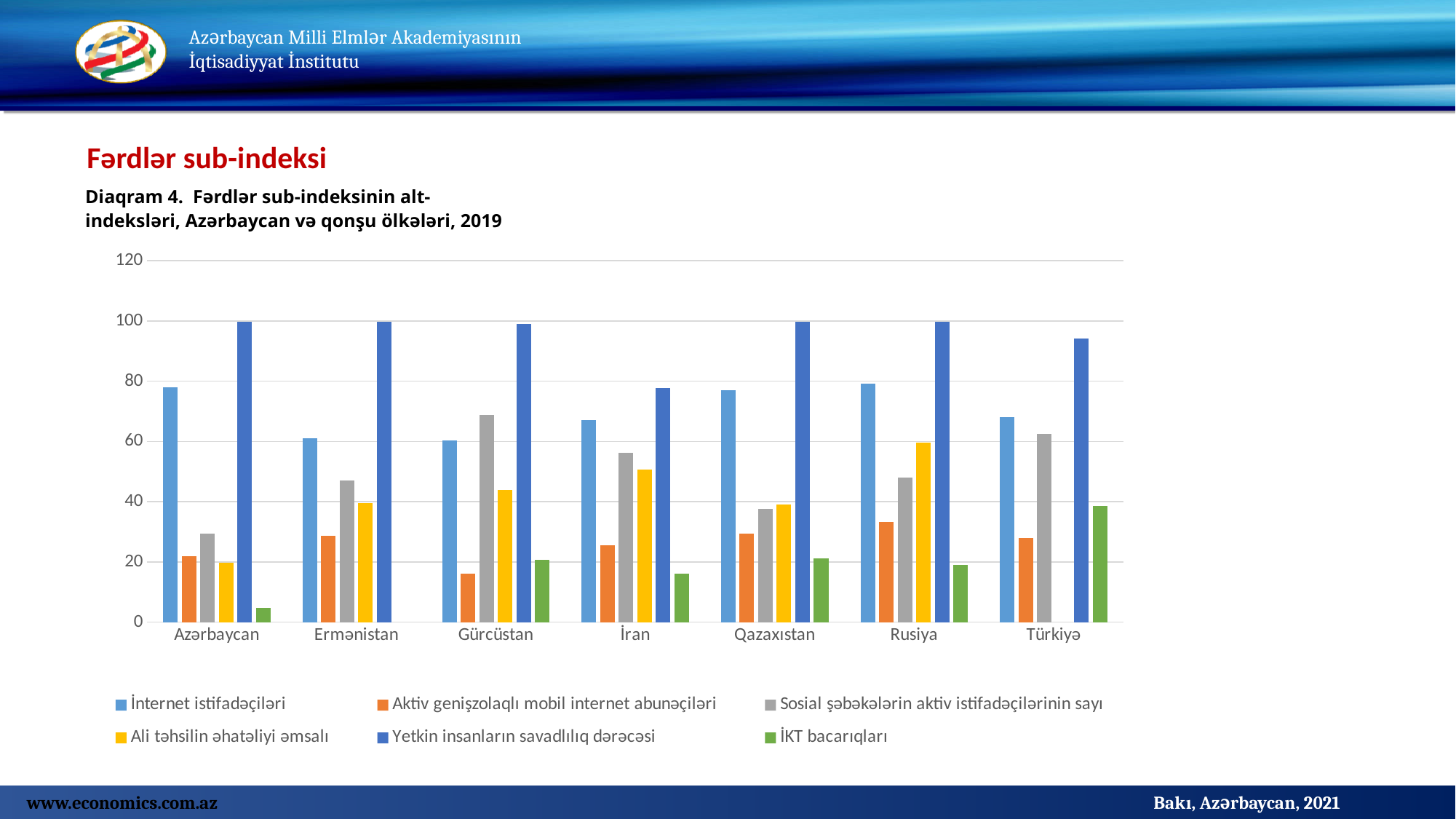
How many series does the chart's legend list? 6 Is the value of Ali təhsilin əhatəliyi əmsalı for Rusiya greater or less than 40? greater What kind of chart is shown on the slide? bar chart Which country has the highest value for Sosial şəbəkələrin aktiv istifadəçilərinin sayı? Gürcüstan Is the value of Sosial şəbəkələrin aktiv istifadəçilərinin sayı for Gürcüstan greater or less than 60? greater Is the value of İKT bacarıqları for Azərbaycan greater or less than 20? less How many countries are shown on the x axis of the chart? 7 What is the title of the diagram on the slide? Diaqram 4. Fərdlər sub-indeksinin alt-indeksləri, Azərbaycan və qonşu ölkələri, 2019 Which country has the lowest value for Yetkin insanların savadlılıq dərəcəsi? İran Which is larger, the Yetkin insanların savadlılıq dərəcəsi value for Azərbaycan or for İran? Azərbaycan Which country has the highest value for İKT bacarıqları? Türkiyə